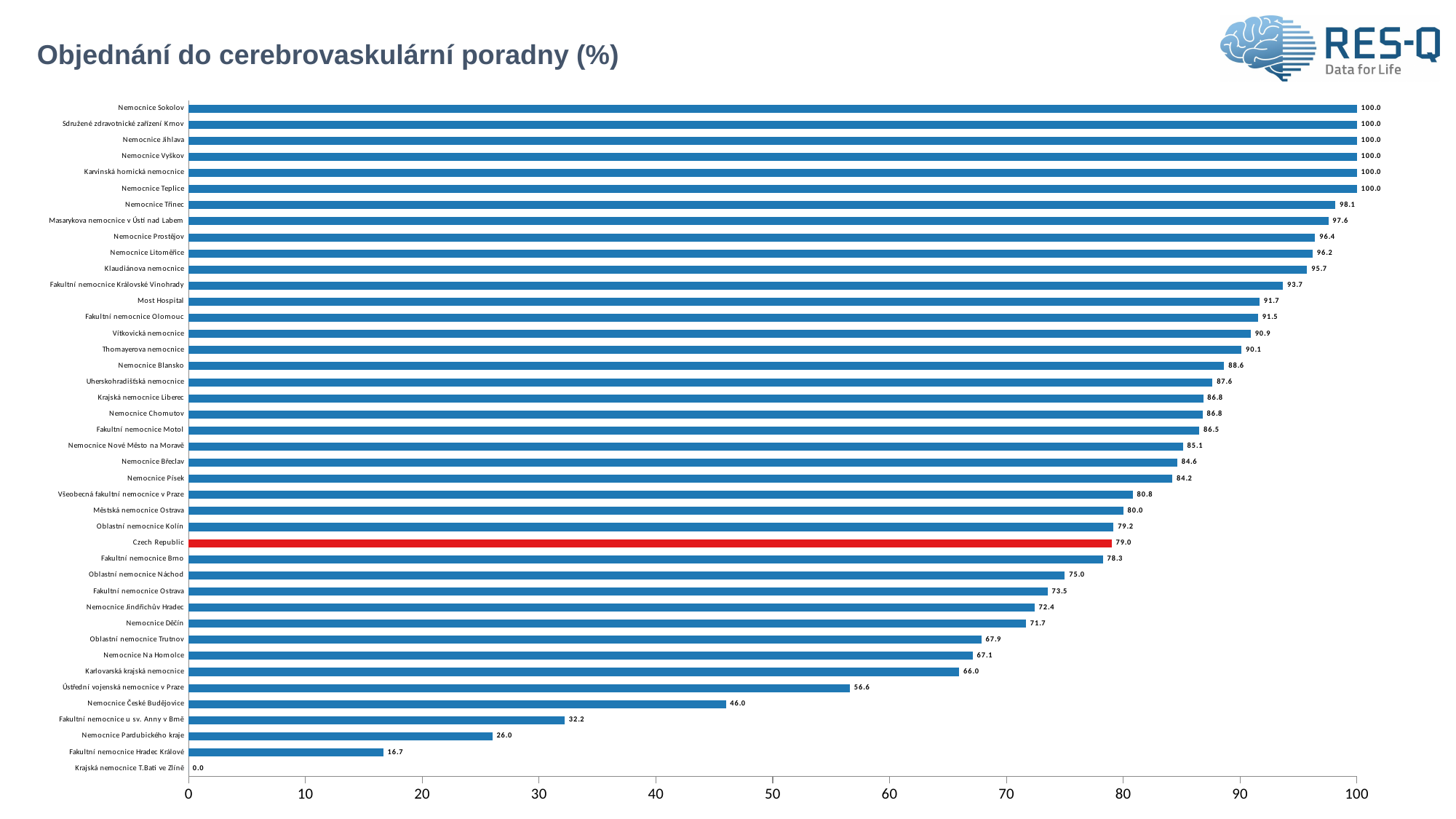
Is the value for Ústřední vojenská nemocnice v Praze greater or less than 60? less What kind of chart is shown on the slide? bar chart What is the value for Fakultní nemocnice Motol? 86.5 What is the title of the chart? Objednání do cerebrovaskulární poradny (%) Which bar is coloured red instead of blue? Czech Republic What is the value for Nemocnice Třinec? 98.1 Which is larger, the value for Nemocnice Děčín or the value for Oblastní nemocnice Trutnov? Nemocnice Děčín How many categories are shown on the chart? 42 What is the value for Nemocnice České Budějovice? 46.0 What is the value for Czech Republic? 79.0 What is the difference between the values for Fakultní nemocnice Brno and Fakultní nemocnice Hradec Králové? 61.6 Which category has the lowest value? Krajská nemocnice T.Bati ve Zlíně